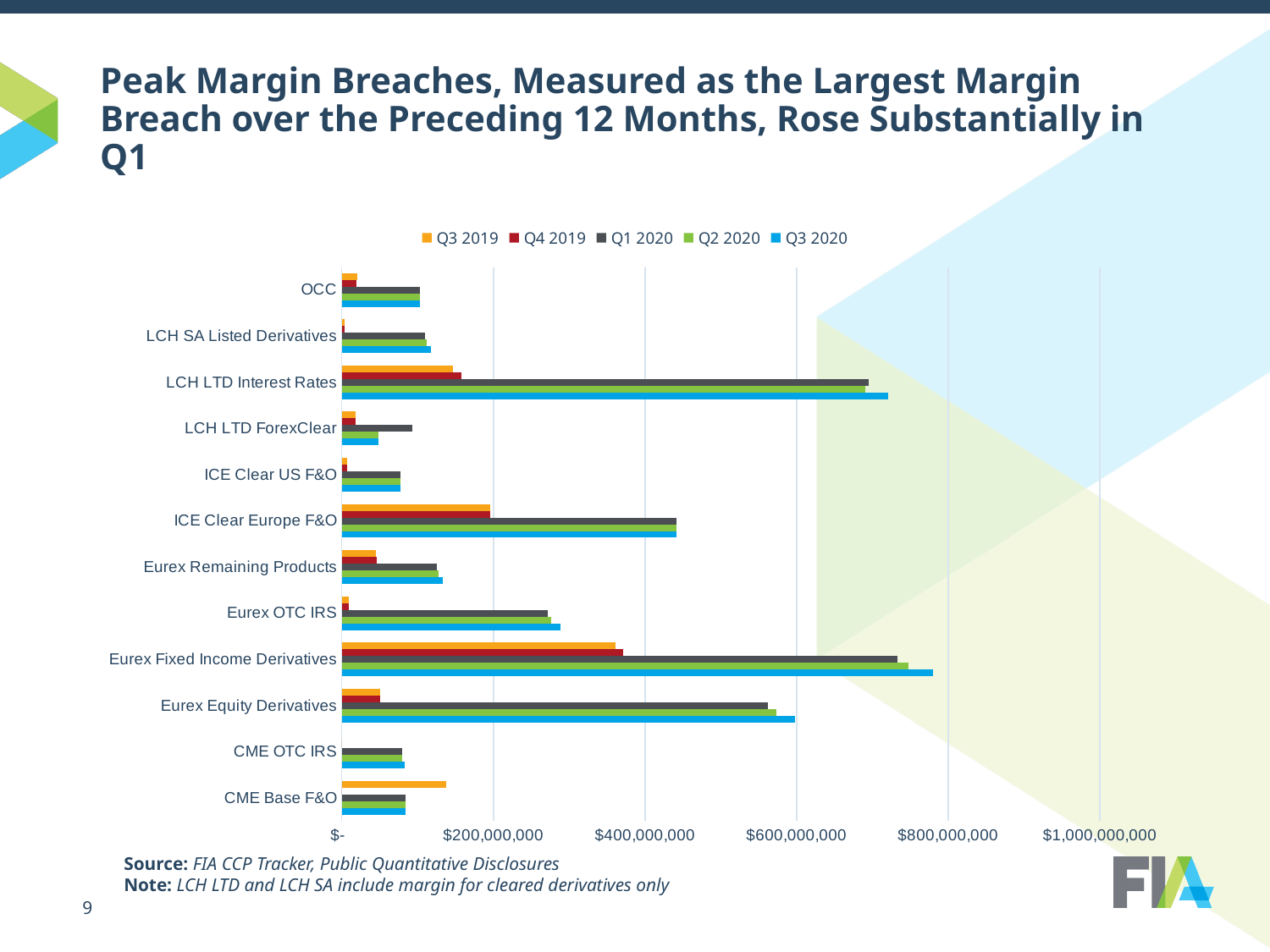
Is the Q3 2020 value for OCC greater or less than $200,000,000? less Is the Q3 2020 value for Eurex Fixed Income Derivatives greater or less than $600,000,000? greater Which quarters are listed in the chart legend? Q3 2019, Q4 2019, Q1 2020, Q2 2020, Q3 2020 Is the Q1 2020 value for ICE Clear Europe F&O greater or less than $600,000,000? less Which category has the highest Q3 2020 value? Eurex Fixed Income Derivatives How many series does the legend list? 5 Which is larger for Q3 2019: ICE Clear Europe F&O or LCH LTD Interest Rates? ICE Clear Europe F&O What kind of chart is shown on the slide? Bar chart Which is larger for Q3 2020: Eurex Fixed Income Derivatives or Eurex Equity Derivatives? Eurex Fixed Income Derivatives How many clearing service categories are plotted on the chart? 12